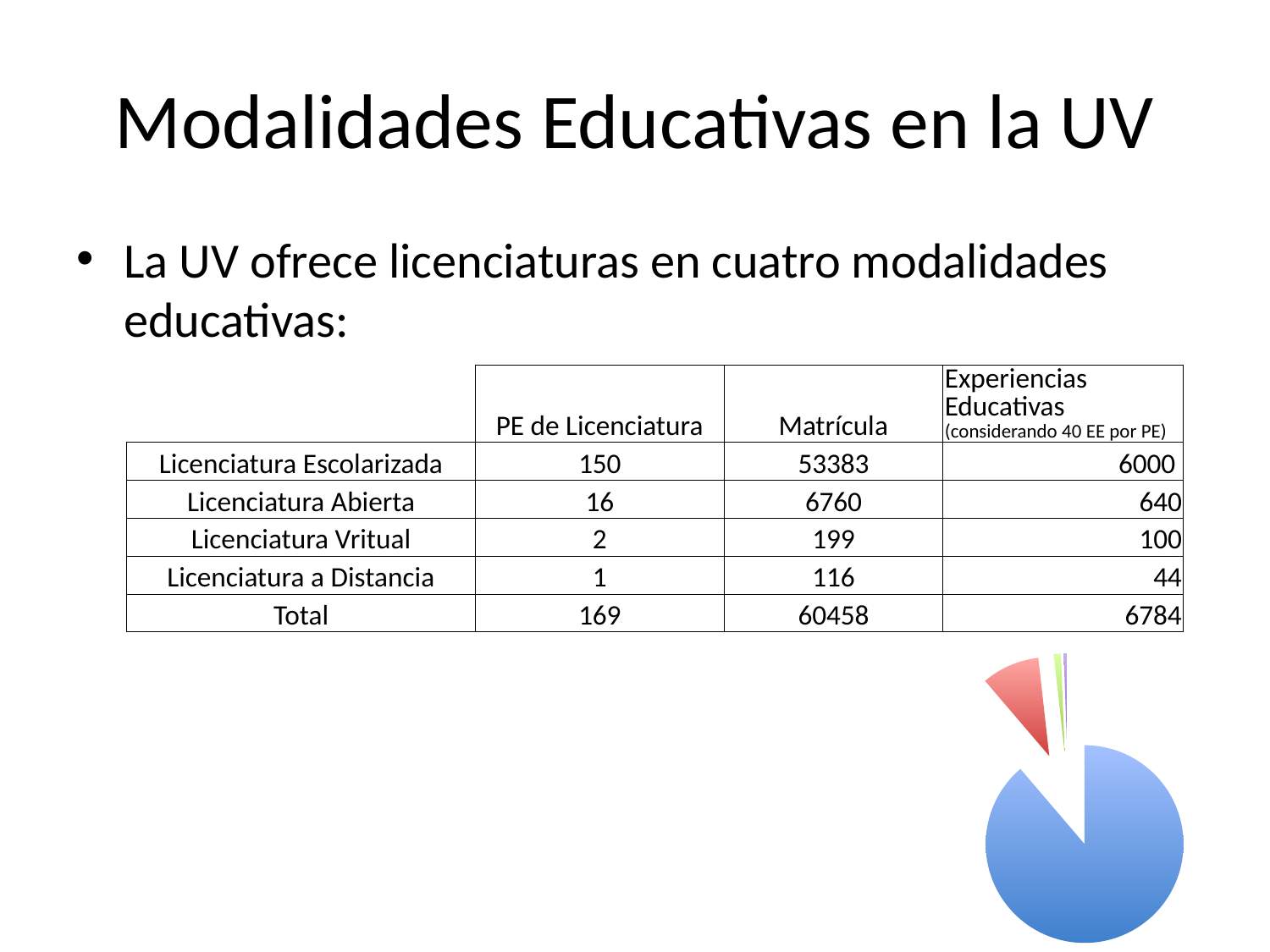
In the pie chart, which colour slice is the largest? blue Does the pie chart show a legend? No Does the pie chart display data labels on its slices? No In the pie chart, is the blue slice larger or smaller than the red slice? larger In the pie chart, does the blue slice take up more or less than half of the pie? more What kind of chart is shown at the bottom right of the slide? pie chart